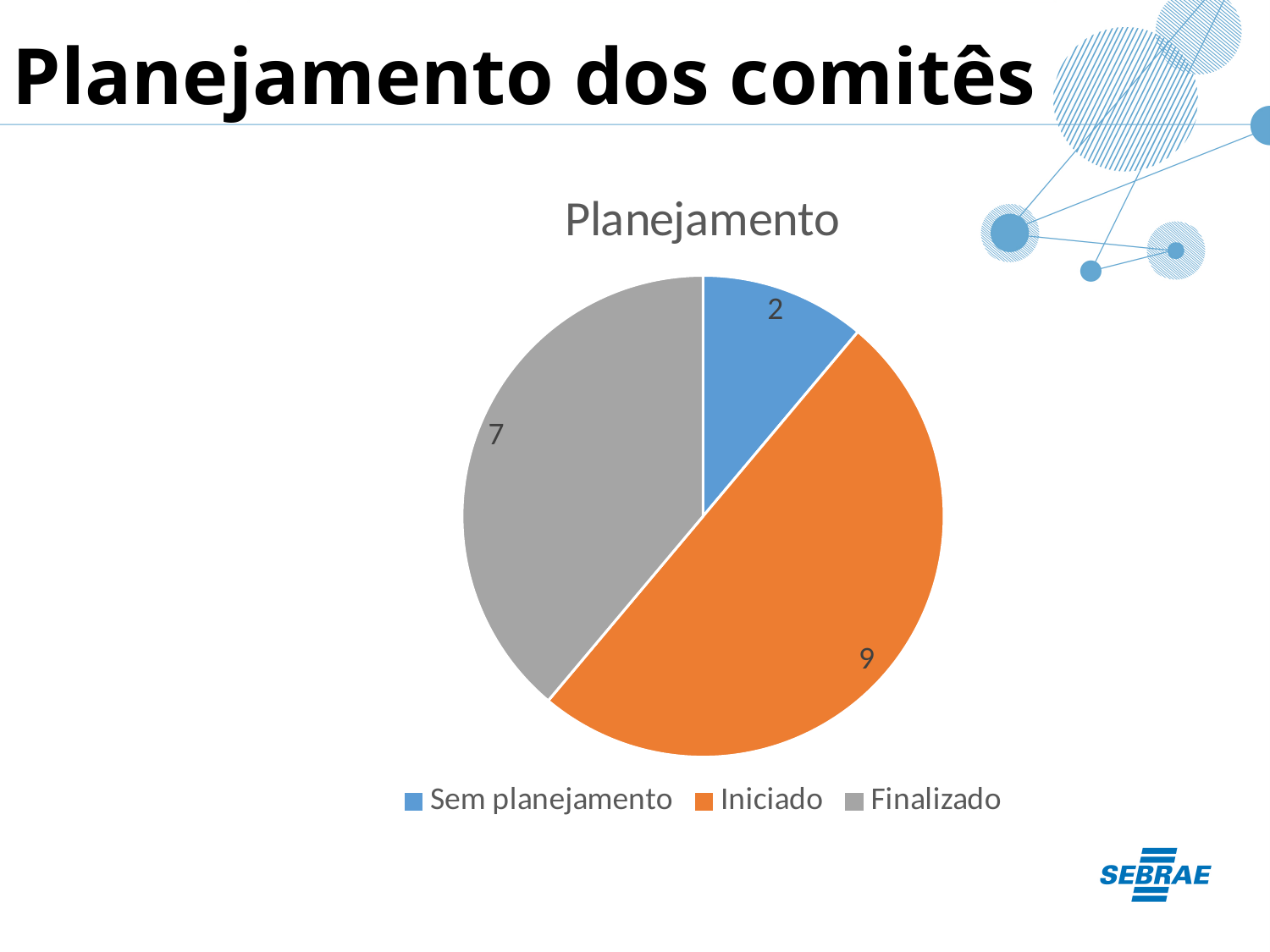
What is the title of the chart? Planejamento How many categories does the pie chart show? 3 What is the value for Finalizado? 7 What is the total of all slices in the pie chart? 18 Which category has the smallest slice? Sem planejamento What is the difference between the values for Finalizado and Sem planejamento? 5 What is the value for Sem planejamento? 2 What is the value for Iniciado? 9 Which is larger, Finalizado or Sem planejamento? Finalizado Which category has the largest slice? Iniciado What kind of chart is shown on the slide? Pie chart What is the difference between the values for Iniciado and Finalizado? 2